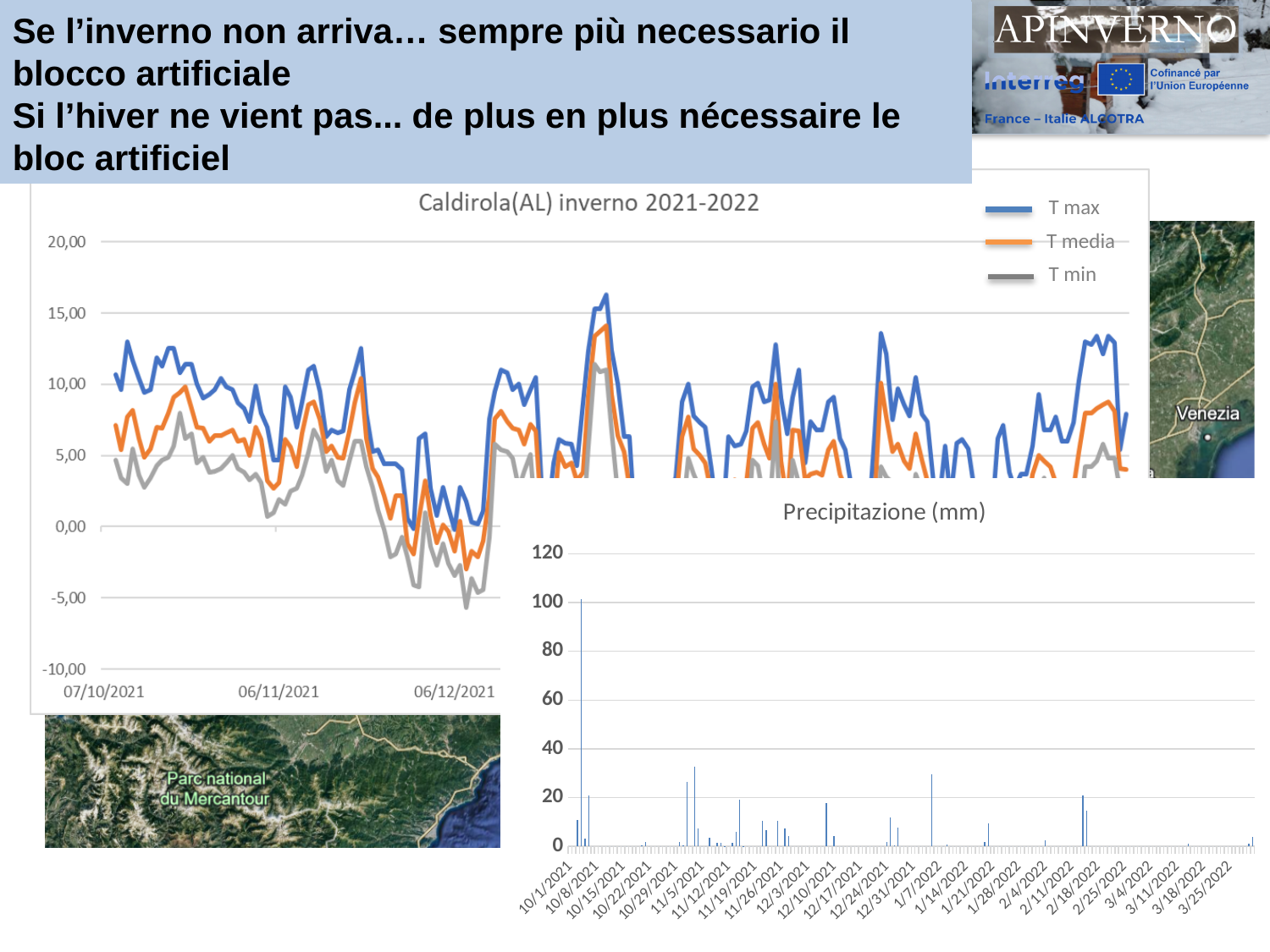
In the 'Caldirola(AL) inverno 2021-2022' chart, is the highest T max value greater or less than 15? greater In the 'Caldirola(AL) inverno 2021-2022' chart, is the lowest T min value greater or less than 0? less In the 'Precipitazione (mm)' chart, is the tallest bar in October 2021 or in February 2022? October 2021 In the 'Caldirola(AL) inverno 2021-2022' chart, does T max generally rise or fall between 07/10/2021 and 06/12/2021? fall In the 'Caldirola(AL) inverno 2021-2022' chart, which series is drawn in orange? T media In the 'Precipitazione (mm)' chart, is the tallest bar greater or less than 80? greater What is the highest value shown on the y axis of the 'Precipitazione (mm)' chart? 120 What kind of chart is the 'Caldirola(AL) inverno 2021-2022' chart? line chart What kind of chart is the 'Precipitazione (mm)' chart? bar chart What is the title of the line chart on the left of the slide? Caldirola(AL) inverno 2021-2022 How many date labels are shown on the x axis of the 'Caldirola(AL) inverno 2021-2022' chart? 3 How many series does the legend of the 'Caldirola(AL) inverno 2021-2022' chart list? 3